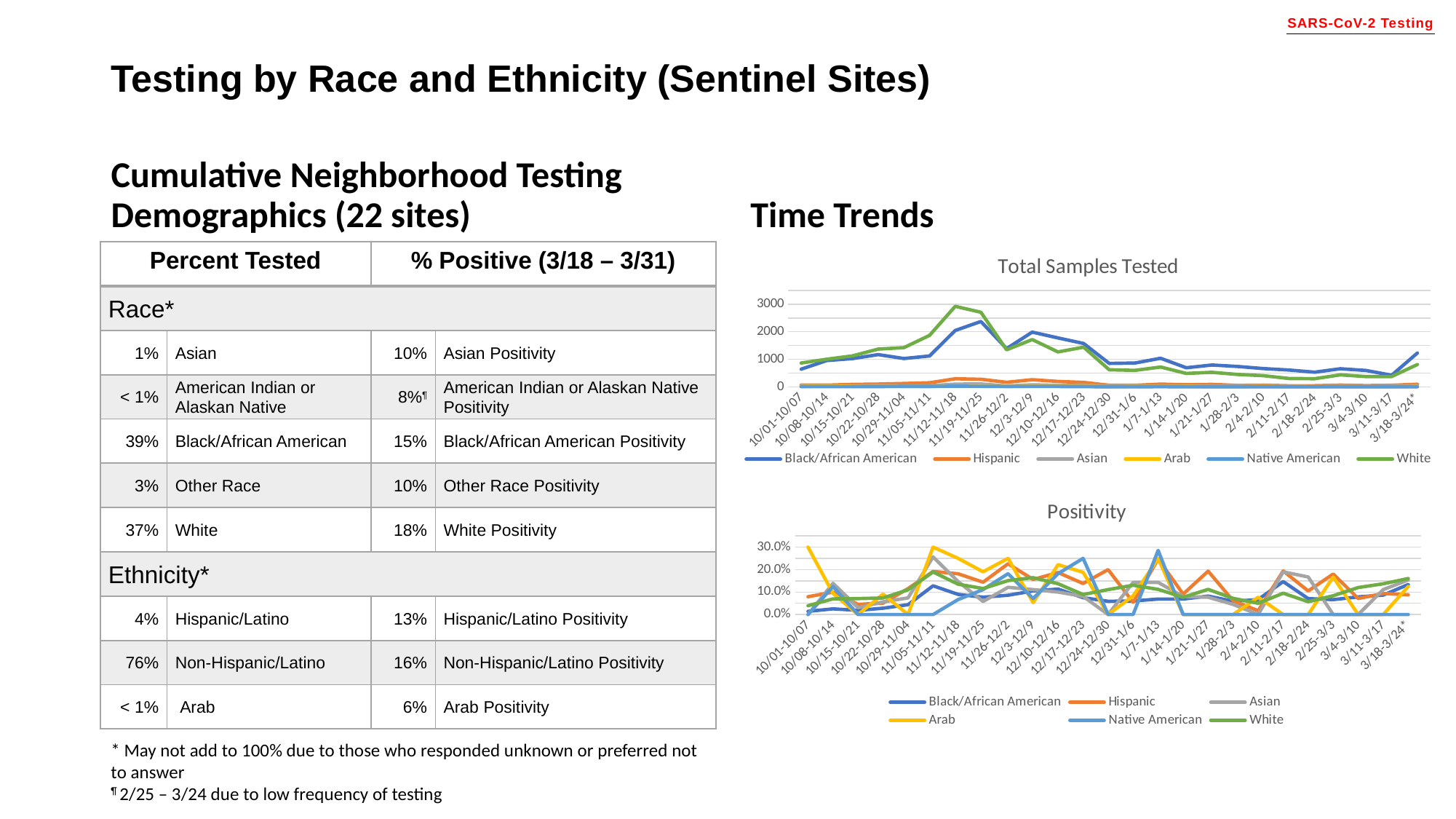
What kind of chart is the "Total Samples Tested" chart? line chart What is the title of the lower chart under "Time Trends"? Positivity In the "Positivity" chart, which series has the highest value in the 10/01-10/07 period? Arab In the "Total Samples Tested" chart, is the value for White in the 11/12-11/18 period greater or less than 2000? greater How many series does the legend of the "Total Samples Tested" chart list? 6 In the "Positivity" chart, is the value for Native American in the 1/7-1/13 period greater or less than 20.0%? greater In the "Total Samples Tested" chart, which is larger in the 11/12-11/18 period: White or Black/African American? White In the "Total Samples Tested" chart, does the Black/African American series rise or fall from 11/19-11/25 to 3/11-3/17? fall How many weekly periods are shown on the x axis of the "Positivity" chart? 25 In the "Total Samples Tested" chart, is the value for Hispanic in the 11/12-11/18 period greater or less than 1000? less In the "Total Samples Tested" chart, which series reaches the highest value overall? White